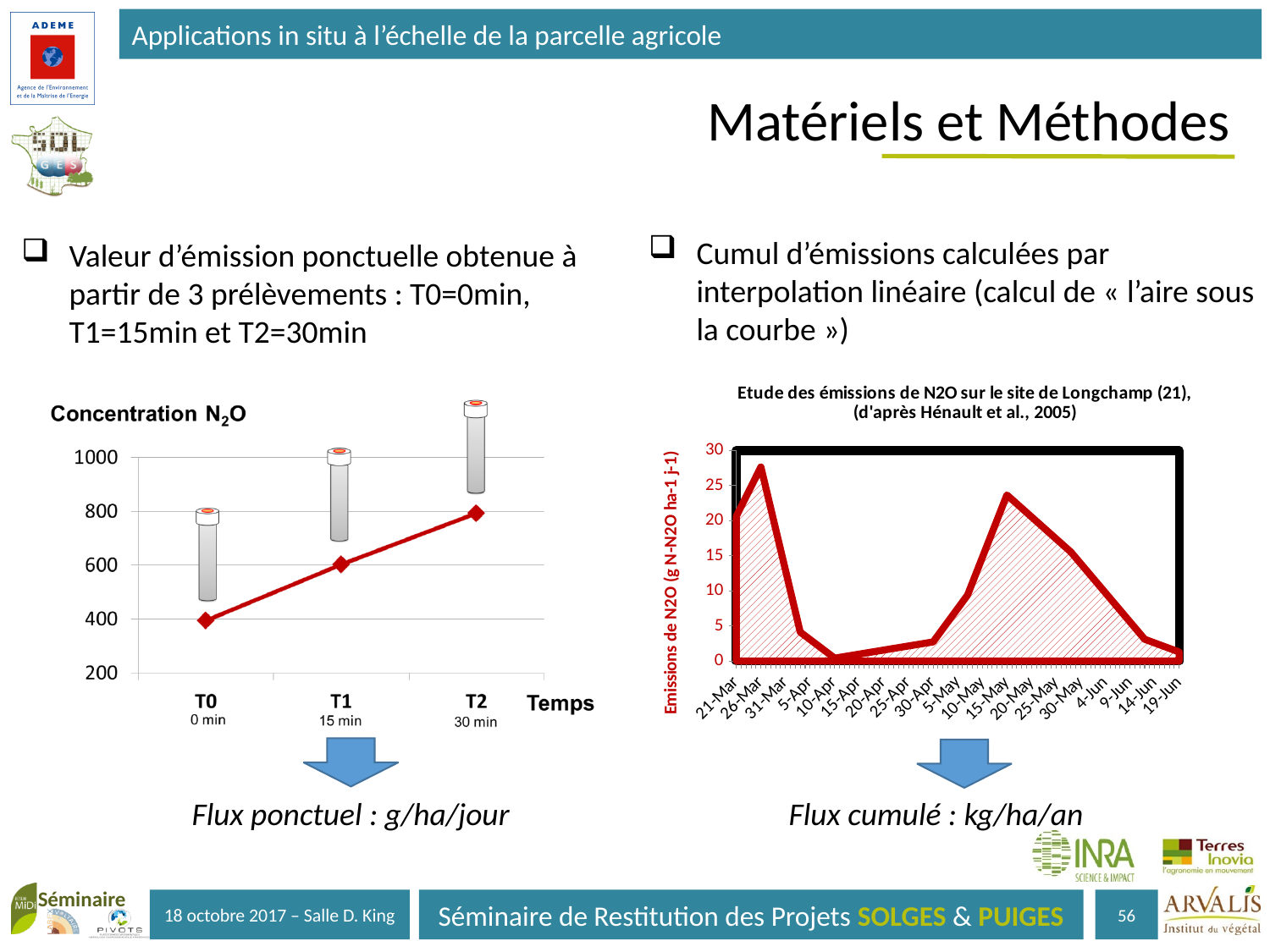
On the left chart (Concentration N2O), is the value at T2 greater or less than 600? greater On the left chart (Concentration N2O), which time point has the lowest concentration? T0 On the right chart (Etude des émissions de N2O sur le site de Longchamp), is the value at 26-Mar greater or less than 25? greater On the left chart (Concentration N2O), how many time points are plotted? 3 On the right chart (Etude des émissions de N2O sur le site de Longchamp), which date has the highest emission value? 26-Mar On the right chart (Etude des émissions de N2O sur le site de Longchamp), is the value at 10-Apr greater or less than 5? less On the left chart (Concentration N2O), which time point has the highest concentration? T2 On the left chart (Concentration N2O), what is the title of the x axis? Temps On the left chart (Concentration N2O), do the values rise or fall from T0 to T2? rise On the right chart (Etude des émissions de N2O sur le site de Longchamp), what is the y-axis label? Emissions de N2O (g N-N2O ha-1 j-1) On the right chart (Etude des émissions de N2O sur le site de Longchamp), is the value at 26-Mar larger or smaller than the value at 15-May? larger